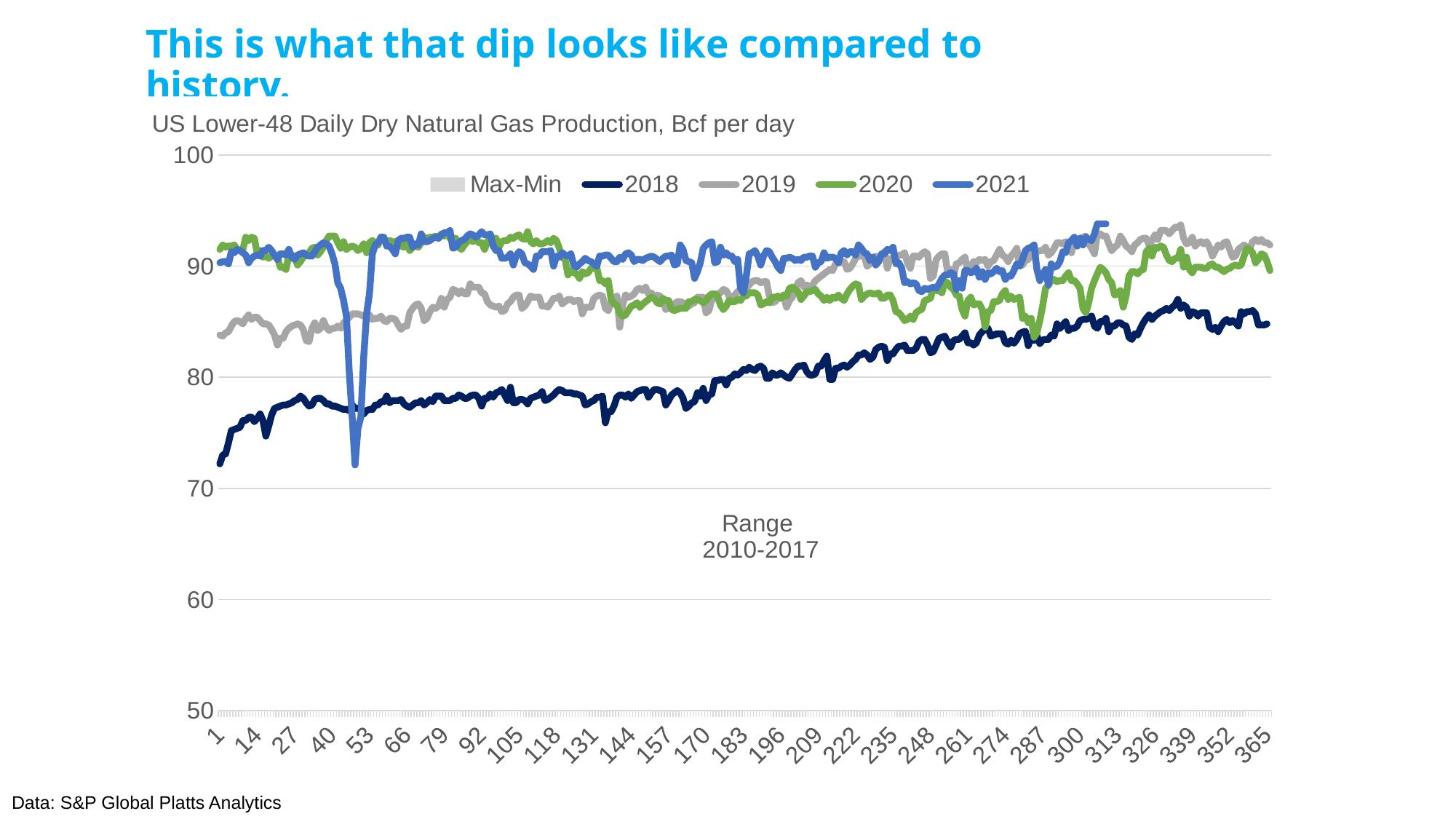
Is the value for 2019 at day 1 greater or less than 90? less Is the value for 2018 at day 1 greater or less than 80? less Is the value for 2020 at day 1 greater or less than 90? greater Which years does the shaded Max-Min range cover, according to the label on the chart? 2010-2017 What kind of chart is shown on the slide? line chart Which series has the lowest values across the whole year? 2018 At day 183, which is larger, the value for 2020 or the value for 2018? 2020 What is the title of the chart? US Lower-48 Daily Dry Natural Gas Production, Bcf per day Does the 2018 line generally rise or fall from day 1 to day 365? rise How many entries does the chart legend list? 5